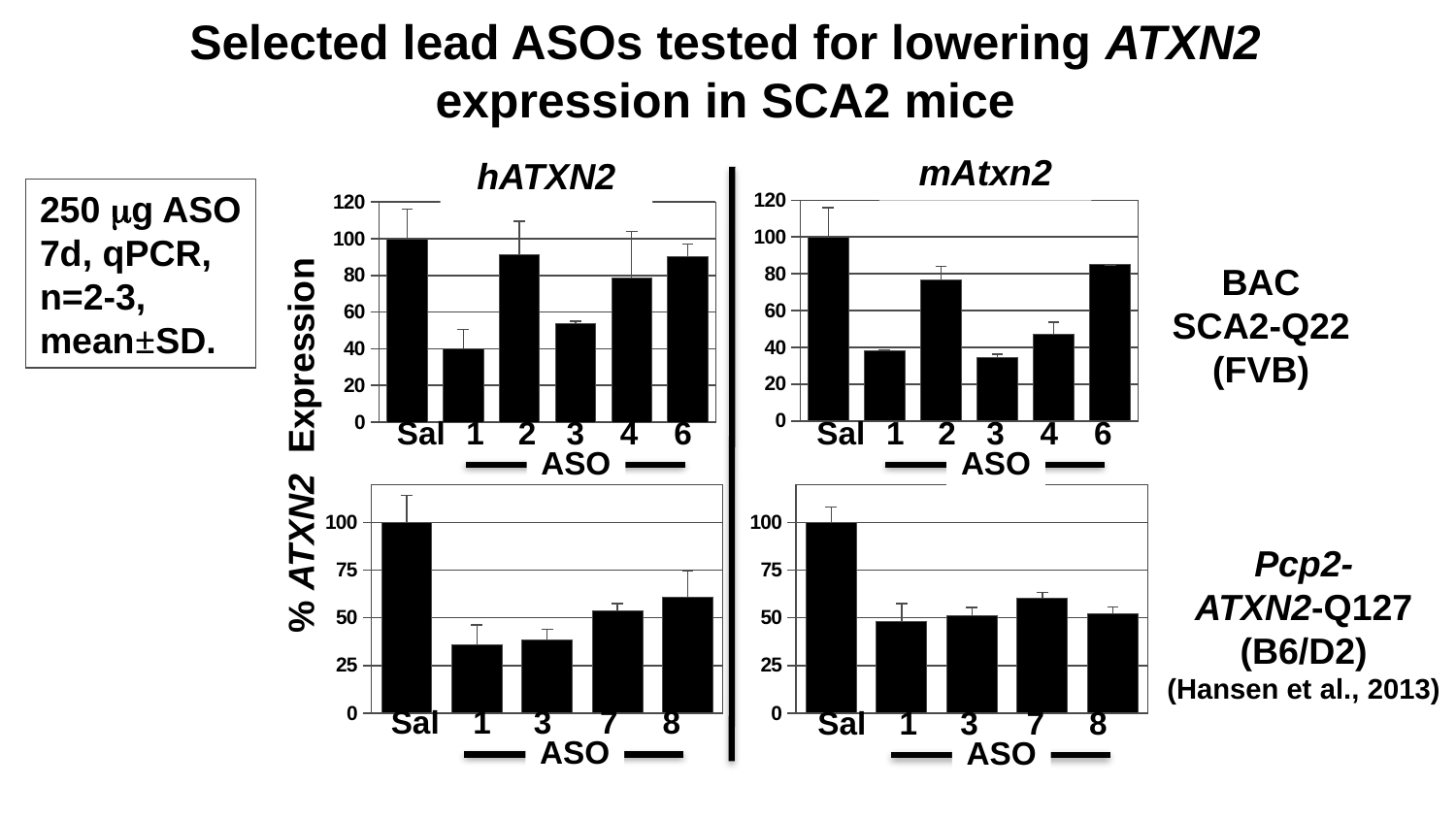
In the top-left hATXN2 chart (BAC SCA2-Q22), how many bars are plotted? 6 In the top-right mAtxn2 chart (BAC SCA2-Q22), which is larger, the value for ASO 2 or ASO 4? ASO 2 In the top-left hATXN2 chart (BAC SCA2-Q22), which category has the lowest value? 1 In the bottom-right mAtxn2 chart (Pcp2-ATXN2-Q127), which is larger, the value for Sal or ASO 7? Sal What is the y-axis label shared by the charts on the slide? % ATXN2 Expression In the bottom-left hATXN2 chart (Pcp2-ATXN2-Q127), how many bars are plotted? 5 In the bottom-left hATXN2 chart (Pcp2-ATXN2-Q127), is the value for ASO 8 greater or less than 50? greater In the top-left hATXN2 chart (BAC SCA2-Q22), what is the value for Sal? 100 In the top-left hATXN2 chart (BAC SCA2-Q22), is the value for ASO 1 greater or less than 60? less In the top-right mAtxn2 chart (BAC SCA2-Q22), is the value for ASO 4 greater or less than 60? less In the top-right mAtxn2 chart (BAC SCA2-Q22), which ASO has the highest value? 6 What kind of chart is the bottom-right mAtxn2 chart (Pcp2-ATXN2-Q127)? bar chart